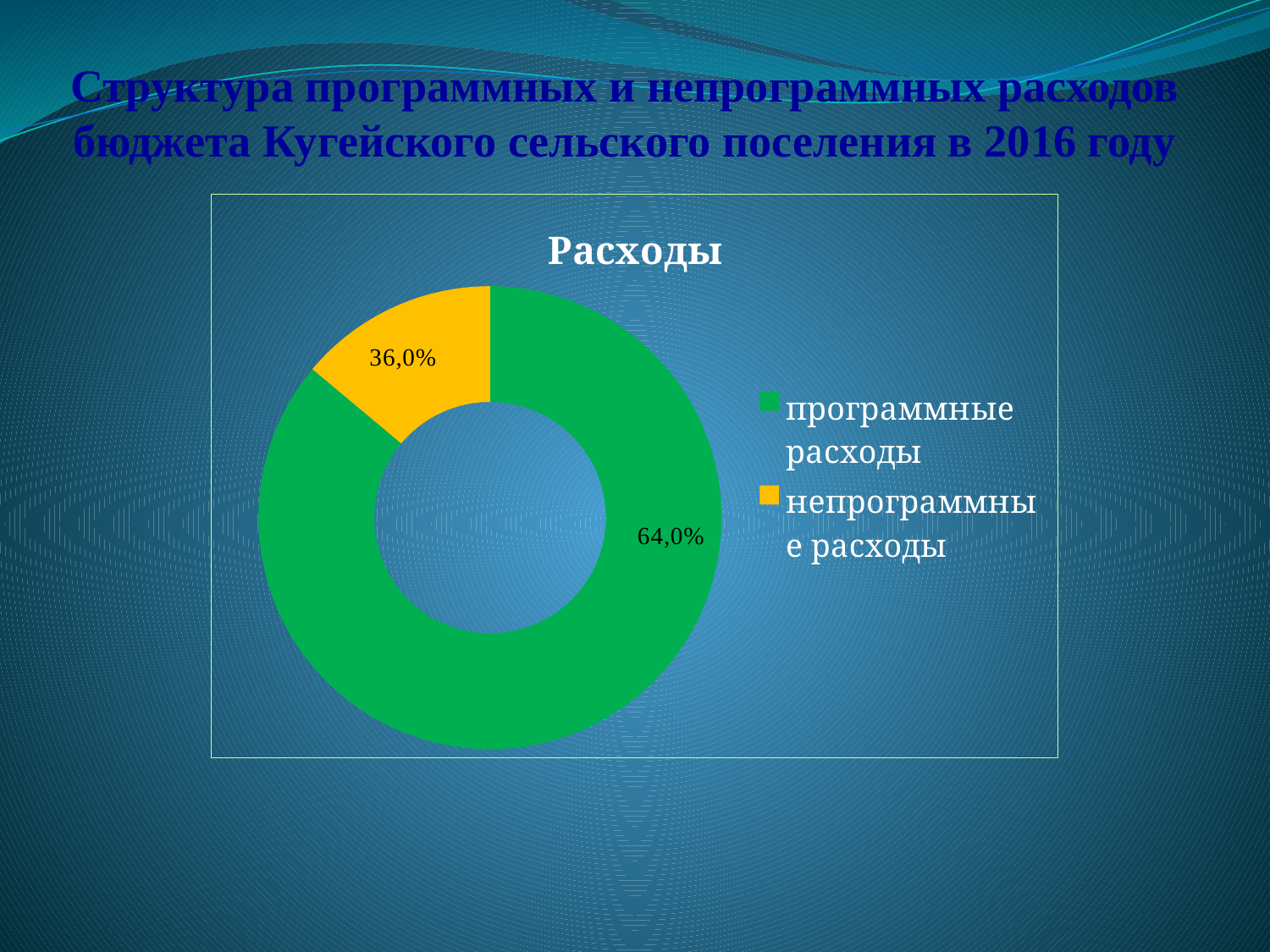
What is the title of the chart? Расходы Which category has the smallest share in the chart? непрограммные расходы What is the difference in percentage points between программные расходы and непрограммные расходы? 28,0% What share of the chart is labelled for программные расходы? 64,0% Is the share of программные расходы greater or less than 50%? greater Which category has the largest share in the chart? программные расходы What type of chart is shown on the slide? Doughnut chart What share of the chart is labelled for непрограммные расходы? 36,0% How many entries does the legend list? 2 What colour represents непрограммные расходы in the chart? Yellow Which is larger: the share of программные расходы or непрограммные расходы? программные расходы How many categories are shown in the chart? 2